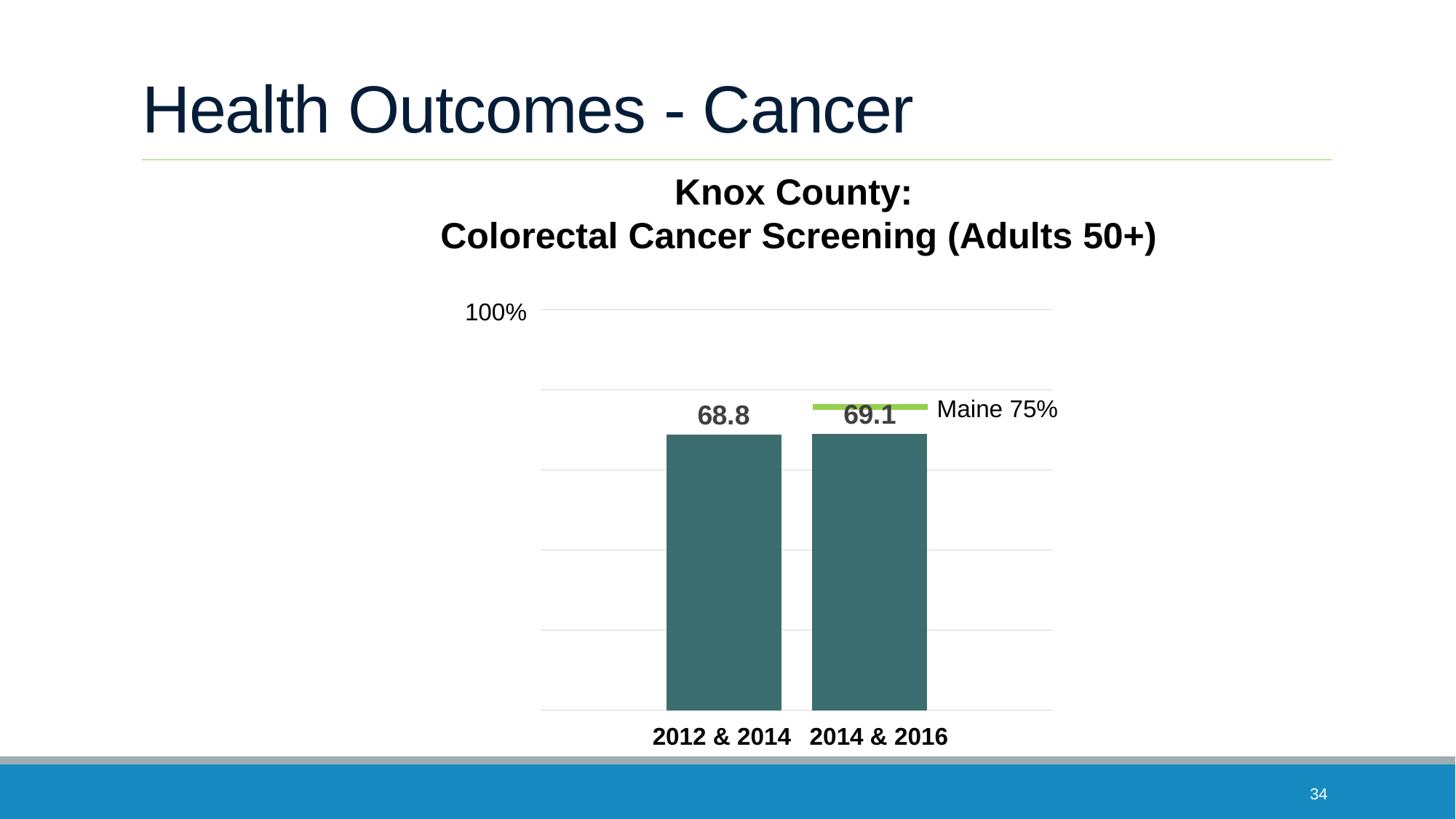
Is the value for 2012 & 2014 larger or smaller than the value for 2014 & 2016? smaller Do the values rise or fall from 2012 & 2014 to 2014 & 2016? rise Is the value for 2014 & 2016 greater or less than 100%? less What is the title of the chart? Knox County: Colorectal Cancer Screening (Adults 50+) What is the difference between the 2014 & 2016 value and the 2012 & 2014 value? 0.3 How many bars are plotted in the chart? 2 Which period has the higher screening value? 2014 & 2016 What kind of chart is shown on the slide? bar chart Which period has the lower screening value? 2012 & 2014 What is the value for 2012 & 2014? 68.8 What is the Maine reference value shown on the chart? 75% What is the value for 2014 & 2016? 69.1